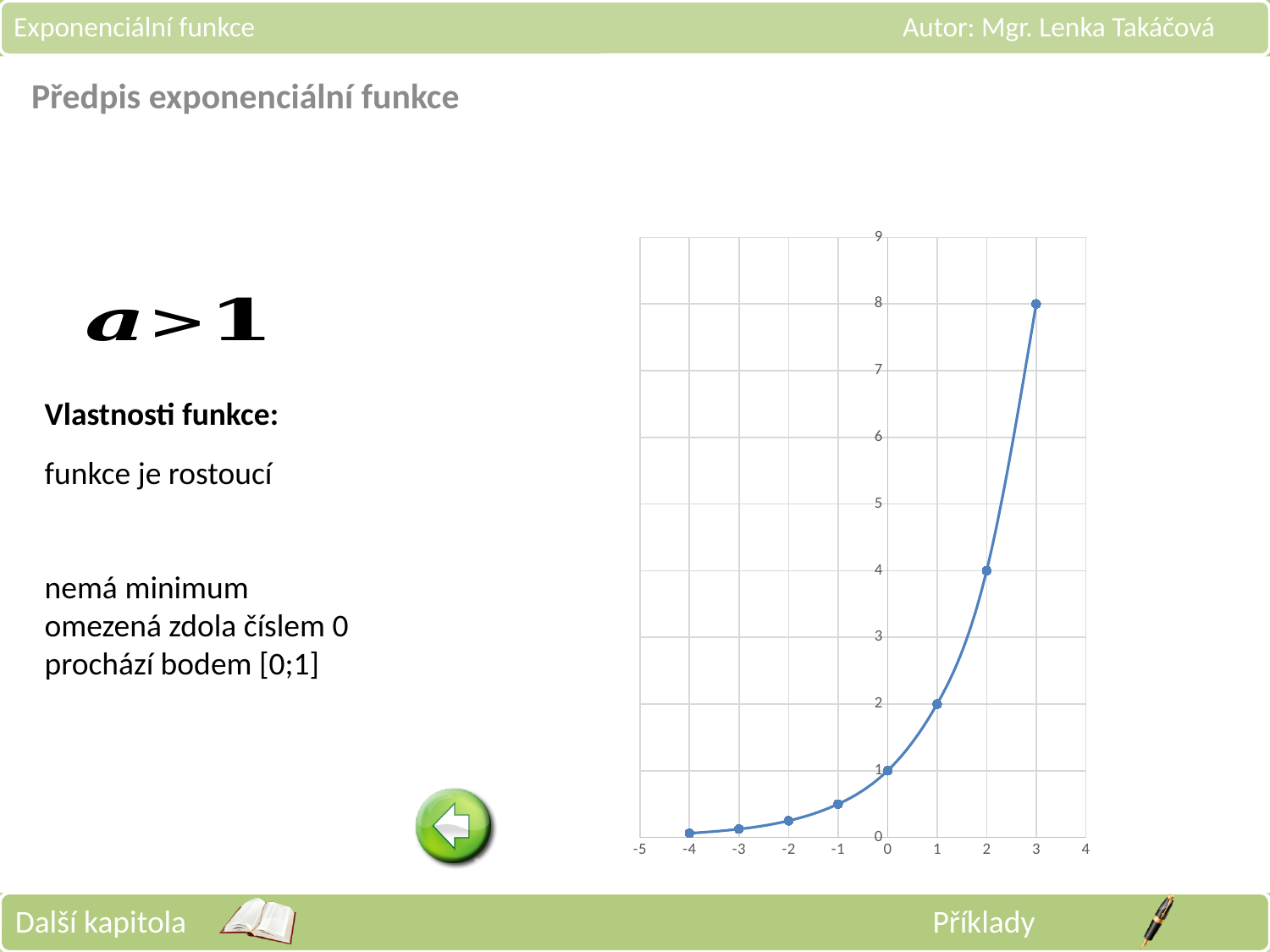
What kind of chart is shown on the slide? line chart What is the y value of the plotted point at x = 2? 4 What is the difference between the y values at x = 3 and x = 2? 4 At which x value does the plotted curve reach its highest point? 3 Do the plotted values rise or fall as x increases? rise What is the y value of the plotted point at x = 1? 2 How many data points are plotted on the chart? 8 What is the y value of the plotted point at x = 3? 8 Which point has the larger y value, the one at x = 2 or the one at x = 1? x = 2 Is the y value of the point at x = -1 greater or less than 1? less What is the y value of the plotted point at x = 0? 1 At which x value is the plotted point lowest? -4